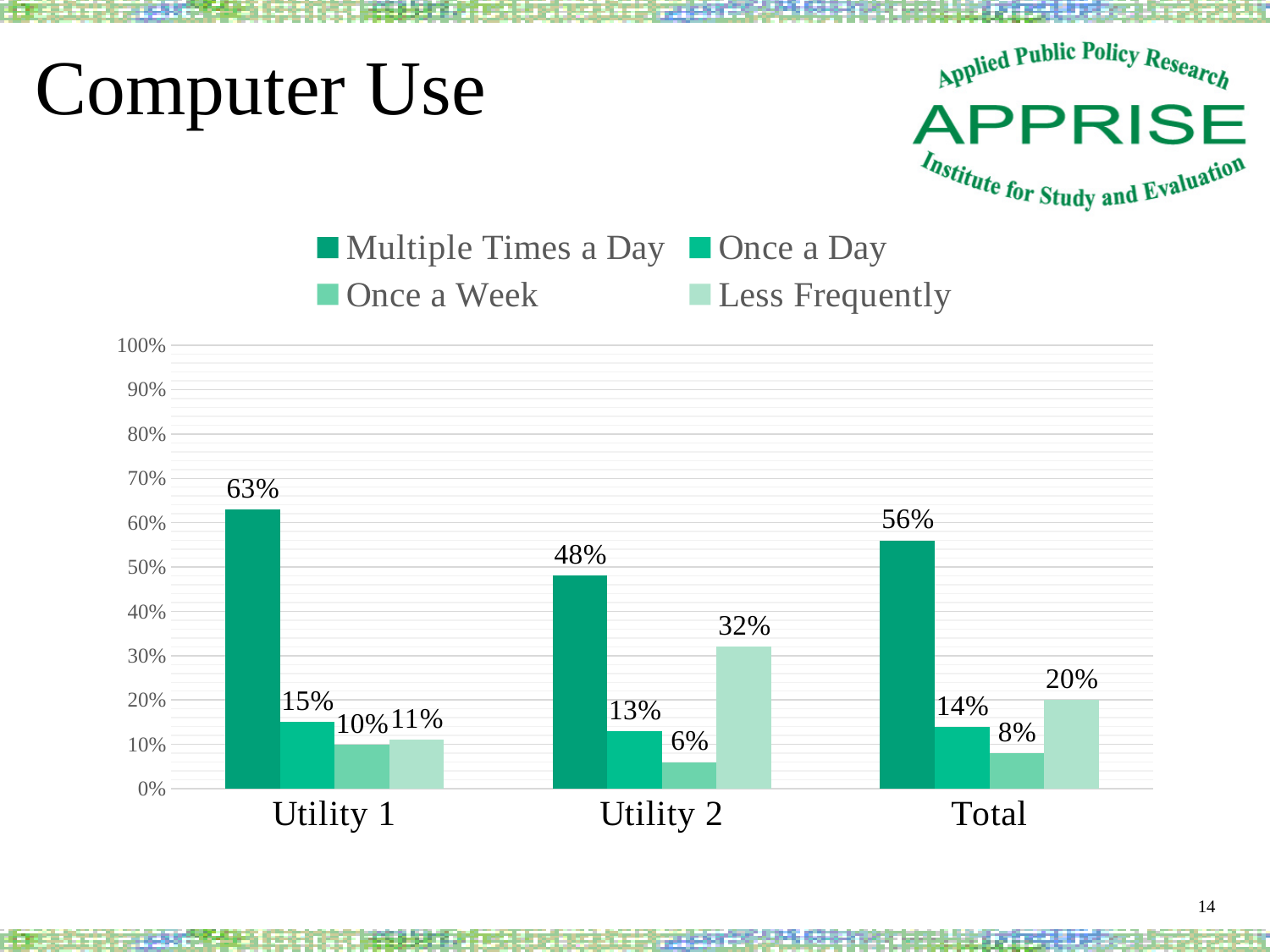
How many categories are shown on the x axis? 3 What is the value for Multiple Times a Day for Utility 1? 63% What is the value for Once a Week for Total? 8% What is the difference between the Multiple Times a Day values for Utility 1 and Utility 2? 15% Which category has the highest value for Multiple Times a Day? Utility 1 Which category has the lowest value for Once a Week? Utility 2 What is the value for Once a Day for Utility 2? 13% What is the value for Less Frequently for Utility 2? 32% Is the value for Multiple Times a Day for Total greater or less than 50%? greater Which is larger for Utility 2: Once a Day or Less Frequently? Less Frequently How many series does the legend list? 4 What kind of chart is shown on the slide? Bar chart